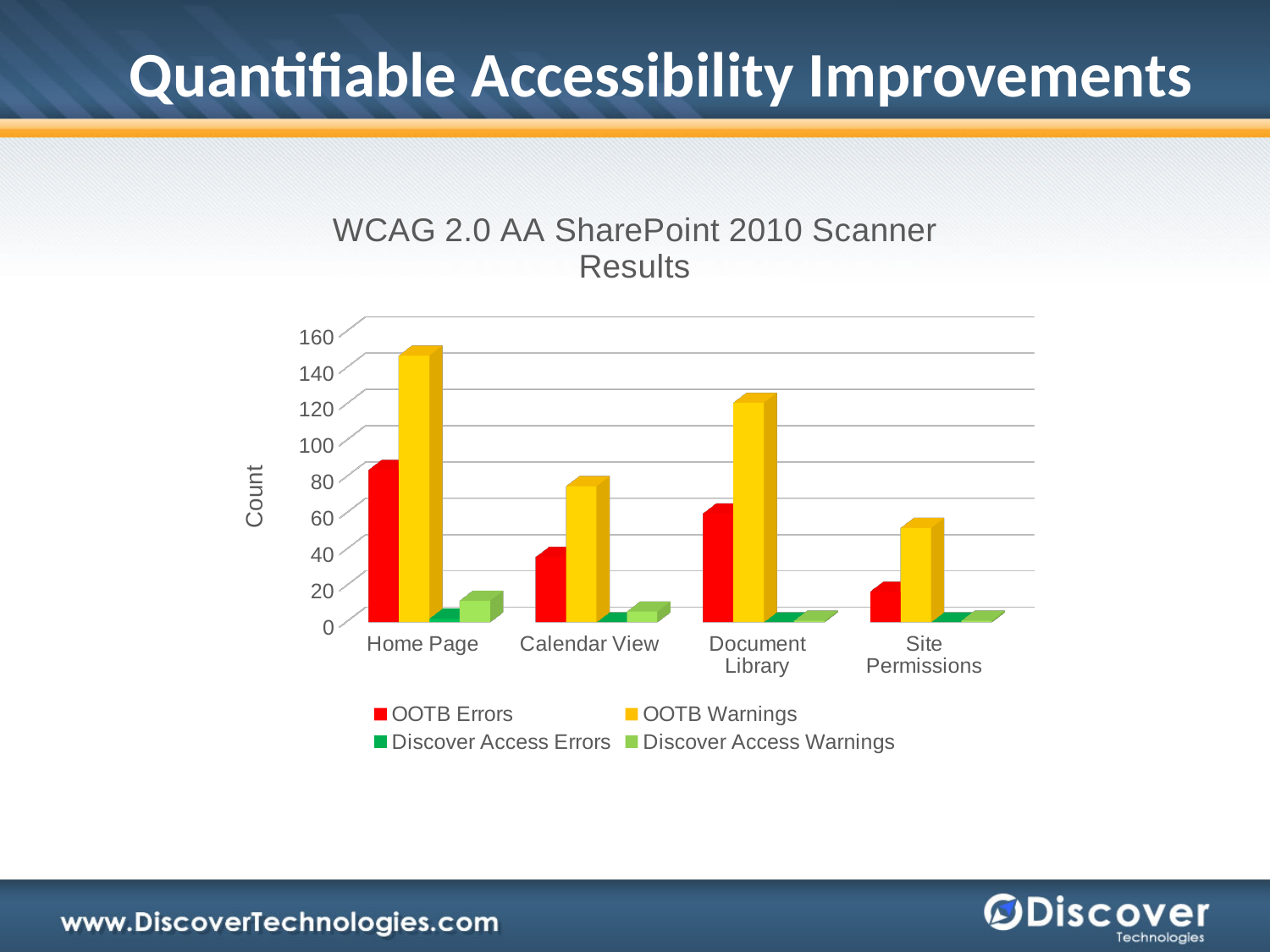
How many series does the legend list? 4 How many categories are shown on the x axis? 4 What kind of chart is shown on the slide? bar chart Is the OOTB Warnings value for Home Page greater or less than 120? greater Which category has the highest OOTB Warnings value? Home Page Which is larger: OOTB Errors for Document Library or OOTB Errors for Calendar View? Document Library Which category has the highest OOTB Errors value? Home Page Which category has the lowest OOTB Errors value? Site Permissions Is the OOTB Warnings value for Document Library greater or less than 100? greater Is the OOTB Errors value for Site Permissions greater or less than 40? less Which is larger for Calendar View: OOTB Errors or OOTB Warnings? OOTB Warnings What is the title of the chart? WCAG 2.0 AA SharePoint 2010 Scanner Results